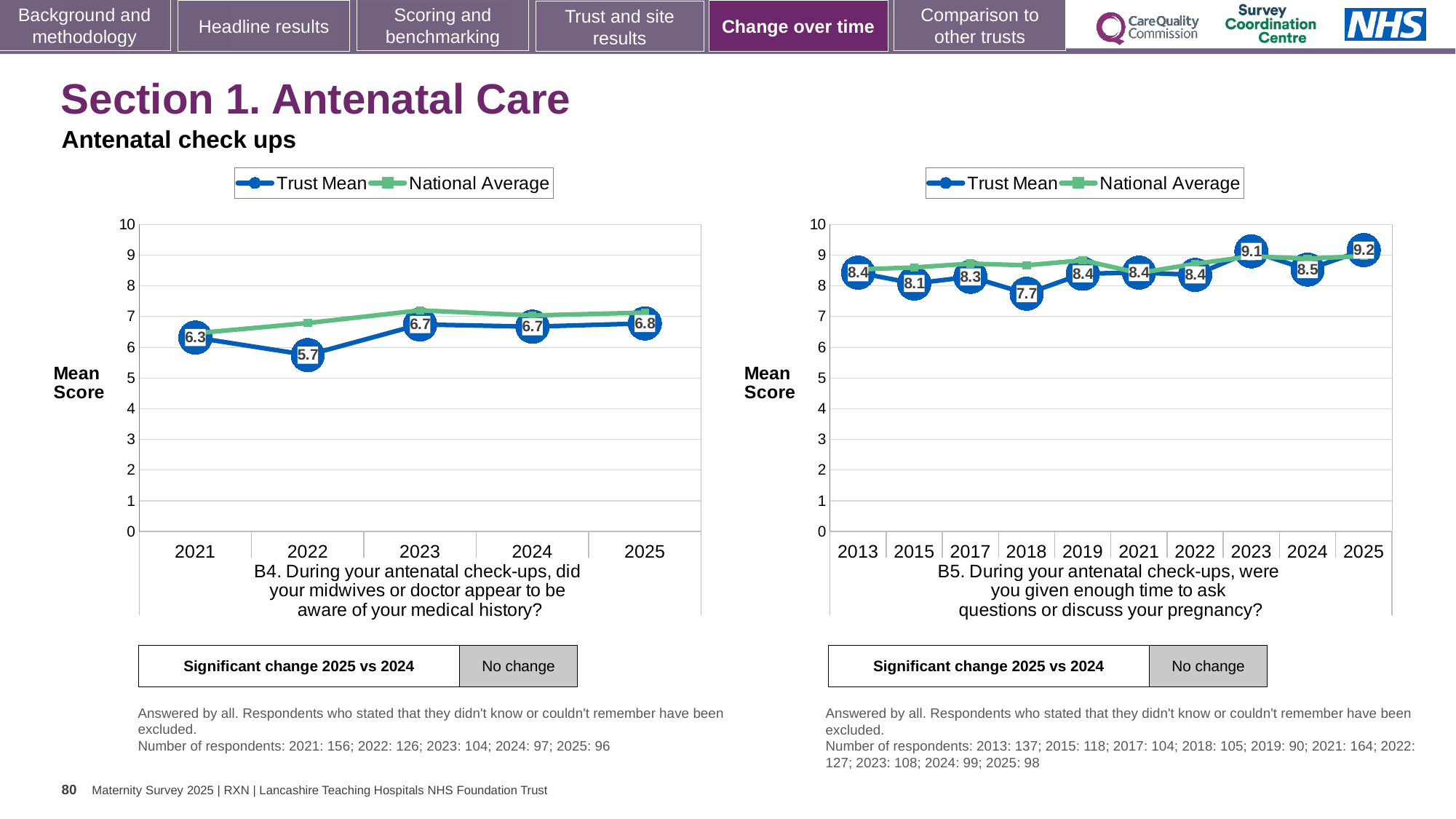
In the B4 chart on the left, which year has the lowest Trust Mean? 2022 In the B4 chart on the left, how many years are shown on the x axis? 5 In the B4 chart on the left, what is the Trust Mean for 2025? 6.8 In the B5 chart on the right, is the Trust Mean larger in 2023 or in 2024? 2023 In the B5 chart on the right, which year has the lowest Trust Mean? 2018 In the B4 chart on the left, what is the Trust Mean for 2022? 5.7 In the B4 chart on the left, what is the difference between the Trust Mean in 2025 and in 2022? 1.1 In the B5 chart on the right, what is the Trust Mean for 2018? 7.7 In the B4 chart on the left, is the National Average for 2022 greater or less than 6? greater How many series does the legend of the B5 chart on the right list? 2 In the B5 chart on the right, which year has the highest Trust Mean? 2025 In the B5 chart on the right, how many years are shown on the x axis? 10